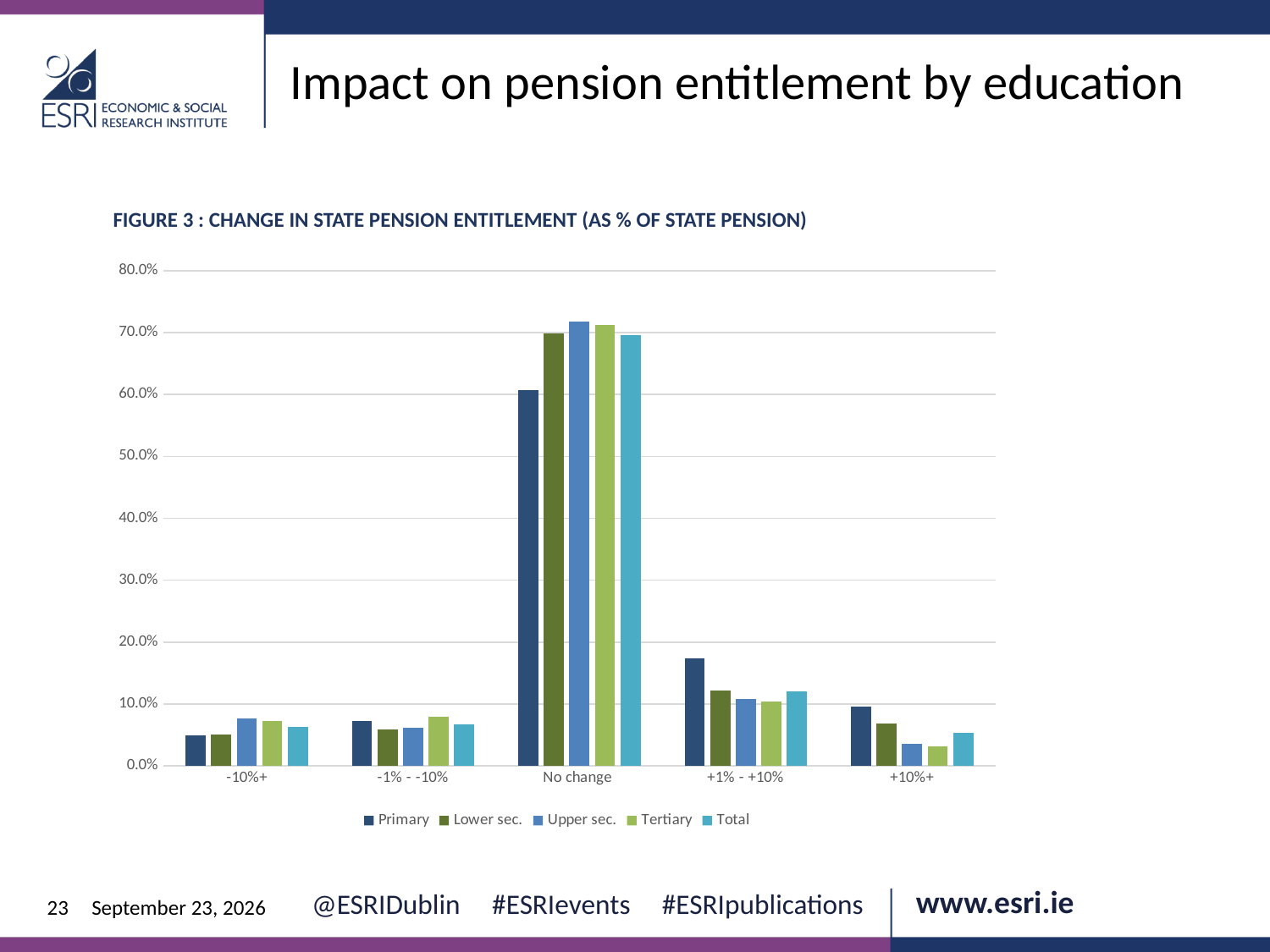
In the No change category, which series has the lowest value? Primary Is the value for Primary in the No change category greater or less than 50.0%? greater Is the value for Upper sec. in the No change category greater or less than 60.0%? greater What is the title of the figure on the slide? FIGURE 3 : CHANGE IN STATE PENSION ENTITLEMENT (AS % OF STATE PENSION) In the +1% - +10% category, which is larger: Primary or Tertiary? Primary Is the value for Primary in the +1% - +10% category greater or less than 20.0%? less In the +10%+ category, which is larger: Primary or Upper sec.? Primary How many series does the legend list? 5 How many categories are shown on the x axis? 5 What kind of chart is shown on the slide? bar chart Which category has the highest value for the Primary series? No change